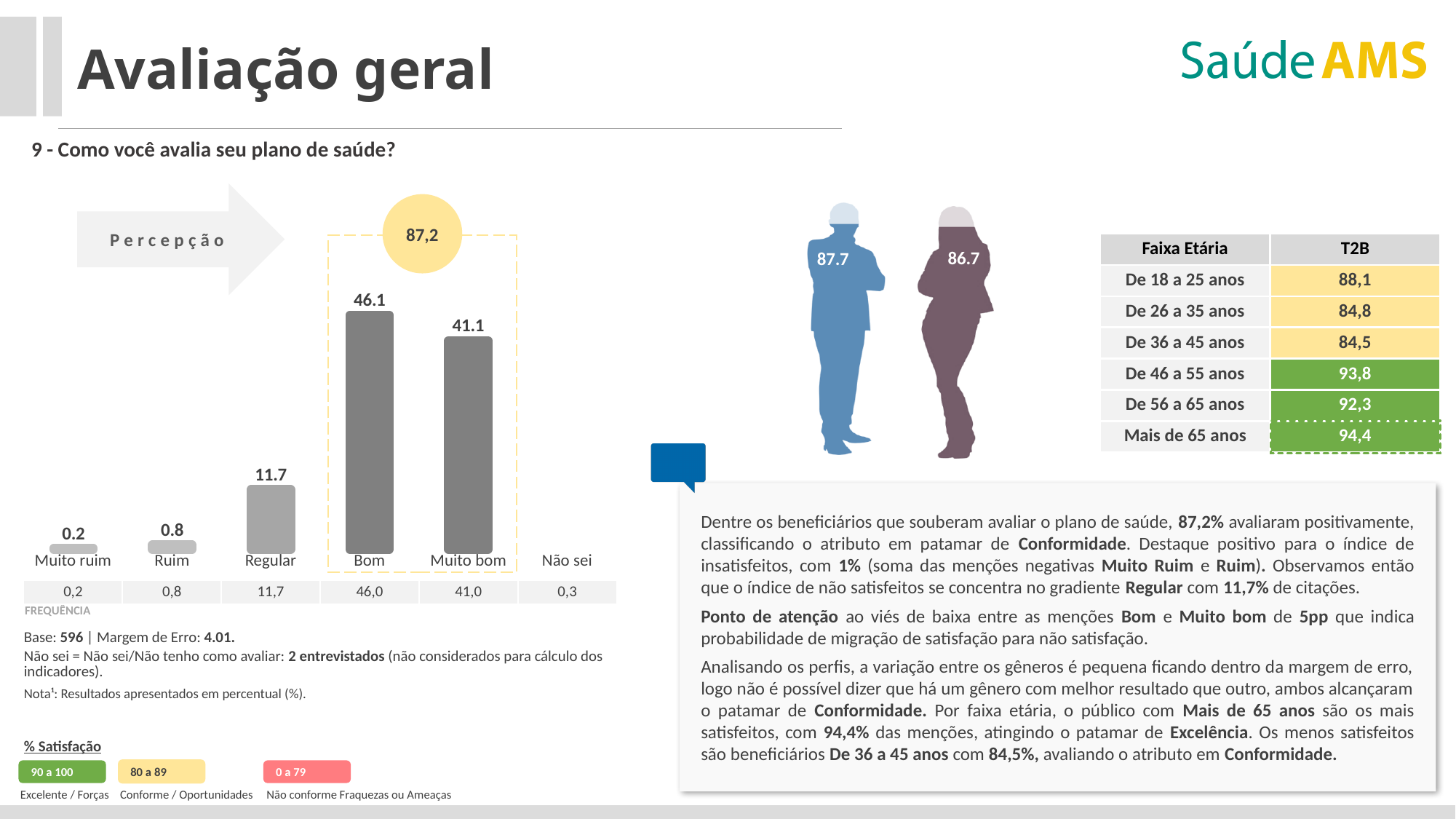
What is the value shown for the Bom bar? 46.1 What is the value shown for the Muito bom bar? 41.1 Which is larger, the Regular bar or the Ruim bar? Regular Which category has the highest bar? Bom How many bars are plotted in the chart? 5 What is the value shown for the Regular bar? 11.7 What is the difference between the Bom and Muito bom bars? 5 What is the frequency value listed for Não sei below the chart? 0,3 What value is shown in the yellow circle above the Bom and Muito bom bars? 87,2 What kind of chart is shown on the slide? Bar chart What is the value shown for the Muito ruim bar? 0.2 Which category has the lowest bar? Muito ruim